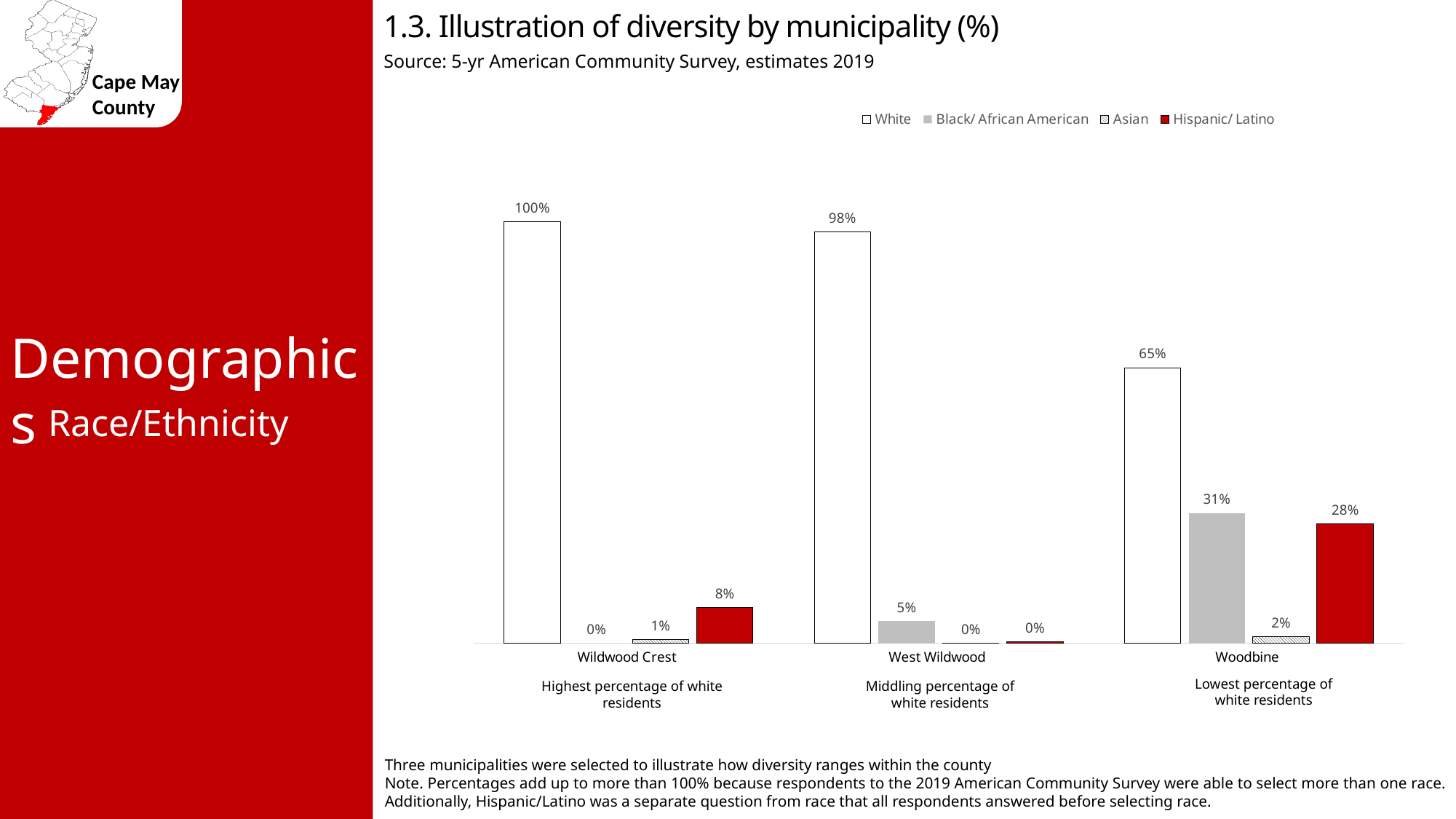
Which municipality has the highest Black/ African American percentage? Woodbine Which series is shown in red on the chart? Hispanic/ Latino Which municipality has the lowest White percentage? Woodbine Which is larger: the Hispanic/ Latino percentage for Wildwood Crest or for West Wildwood? Wildwood Crest What is the Hispanic/ Latino percentage for Woodbine? 28% How many municipalities are shown on the chart? 3 What is the difference between the White percentage for Wildwood Crest and for Woodbine? 35% What is the White percentage for Wildwood Crest? 100% What is the Asian percentage for Woodbine? 2% What kind of chart is shown on the slide? Bar chart What is the Black/ African American percentage for West Wildwood? 5% How many series does the legend list? 4